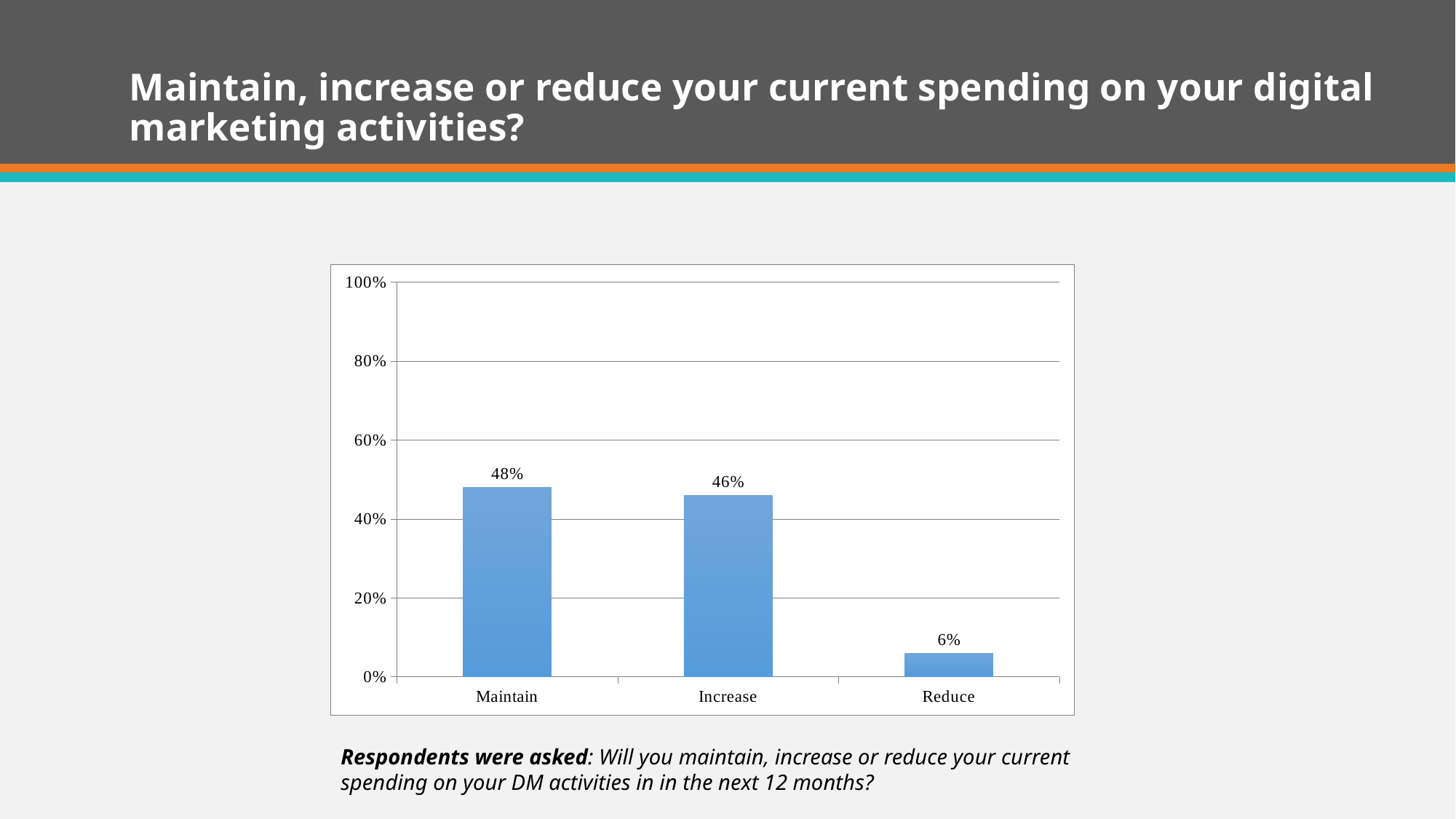
What percentage of respondents said they would maintain their current spending? 48% Is the value for Maintain greater or less than 40%? greater What is the difference between the Maintain and Increase values? 2% What percentage of respondents said they would reduce their spending? 6% What is the maximum value shown on the y axis? 100% What kind of chart is shown on the slide? Bar chart Which category has the lowest value? Reduce Which is larger, the value for Increase or the value for Reduce? Increase How many categories are shown on the x axis? 3 What percentage of respondents said they would increase their spending? 46% Which category has the highest value? Maintain What is the difference between the Increase and Reduce values? 40%